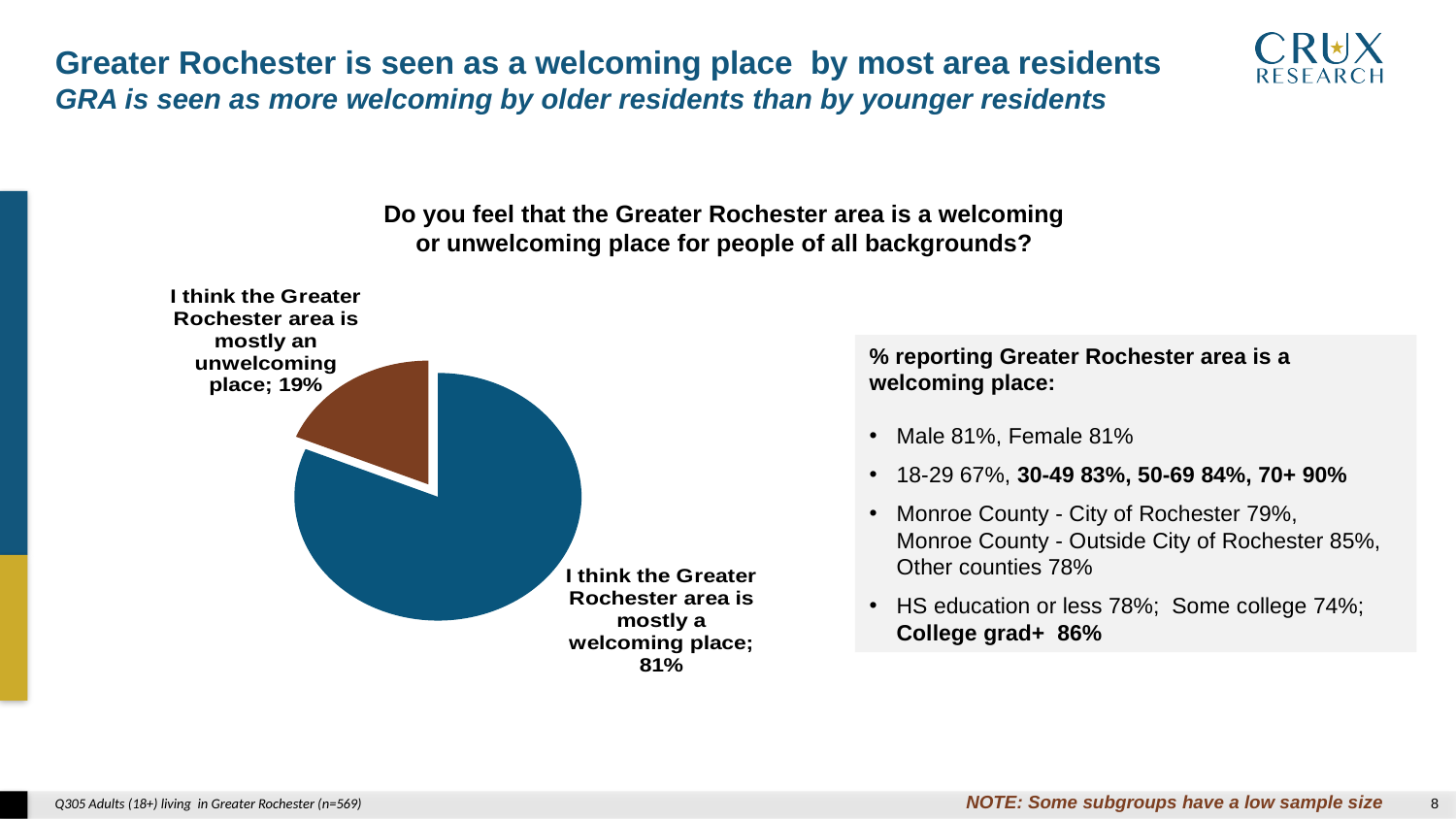
Which slice of the pie chart is the smallest? I think the Greater Rochester area is mostly an unwelcoming place What share of the pie does the 'mostly an unwelcoming place' slice represent? 19% What is the difference in percentage points between the welcoming and unwelcoming slices? 62 How many slices does the pie chart have? 2 Which slice of the pie chart is the largest? I think the Greater Rochester area is mostly a welcoming place What kind of chart is shown on the slide? pie chart What percentage of respondents think the Greater Rochester area is mostly an unwelcoming place? 19% What percentage of respondents think the Greater Rochester area is mostly a welcoming place? 81% What colour is the slice for 'mostly a welcoming place'? blue What question is the pie chart based on, as shown in the chart title? Do you feel that the Greater Rochester area is a welcoming or unwelcoming place for people of all backgrounds? Which is larger: the share saying the area is mostly welcoming or the share saying it is mostly unwelcoming? mostly welcoming